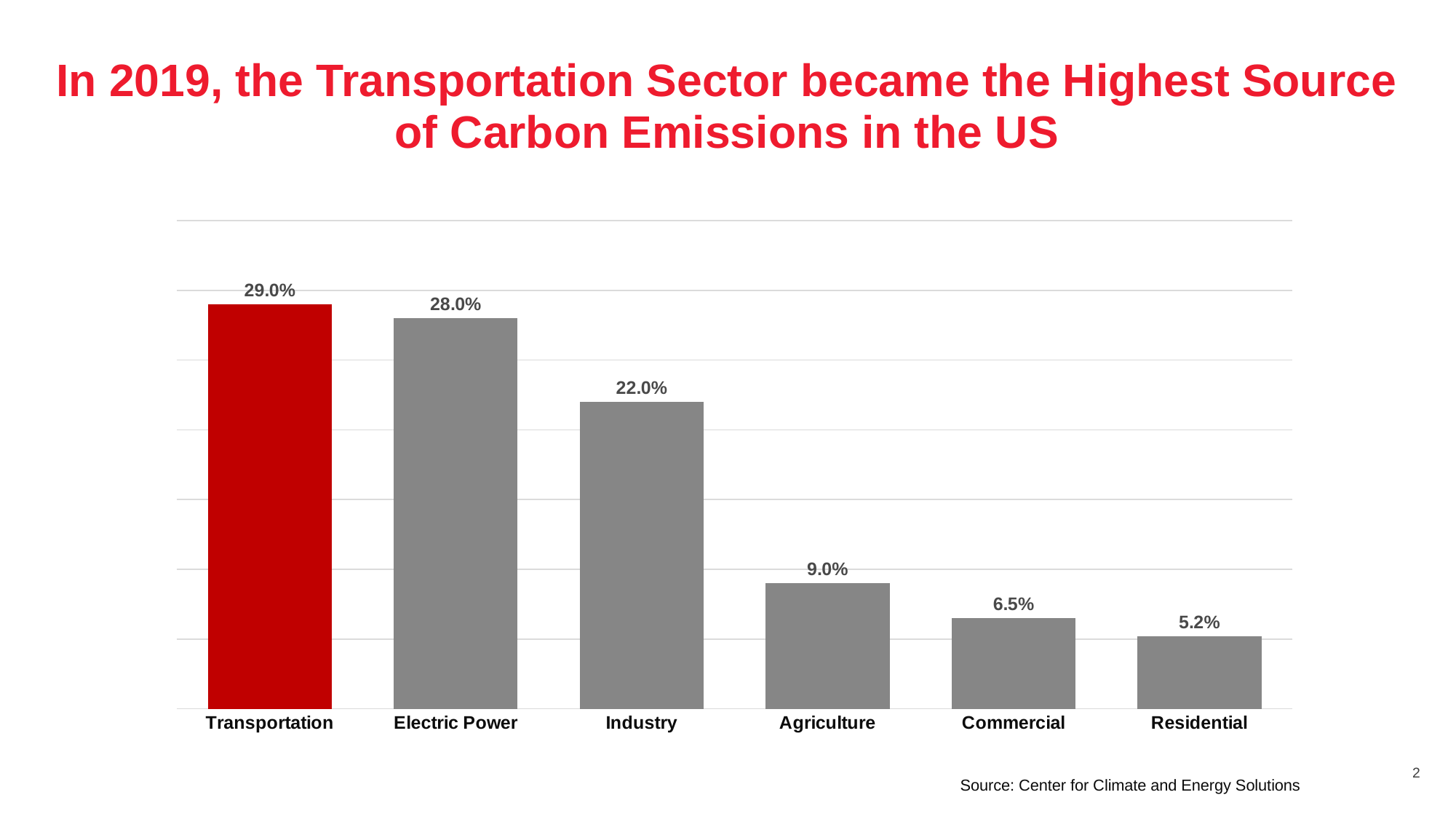
What is the difference between the values for Industry and Agriculture? 13.0% Which is larger, the value for Agriculture or the value for Commercial? Agriculture Do the values rise or fall from left to right along the x axis? Fall What is the value for Industry? 22.0% What is the difference between the values for Transportation and Electric Power? 1.0% What kind of chart is shown on the slide? Bar chart Which category has the highest value? Transportation Which bar is coloured red rather than grey? Transportation What is the value for Transportation? 29.0% Which category has the lowest value? Residential How many categories are shown in the chart? 6 What is the value for Commercial? 6.5%